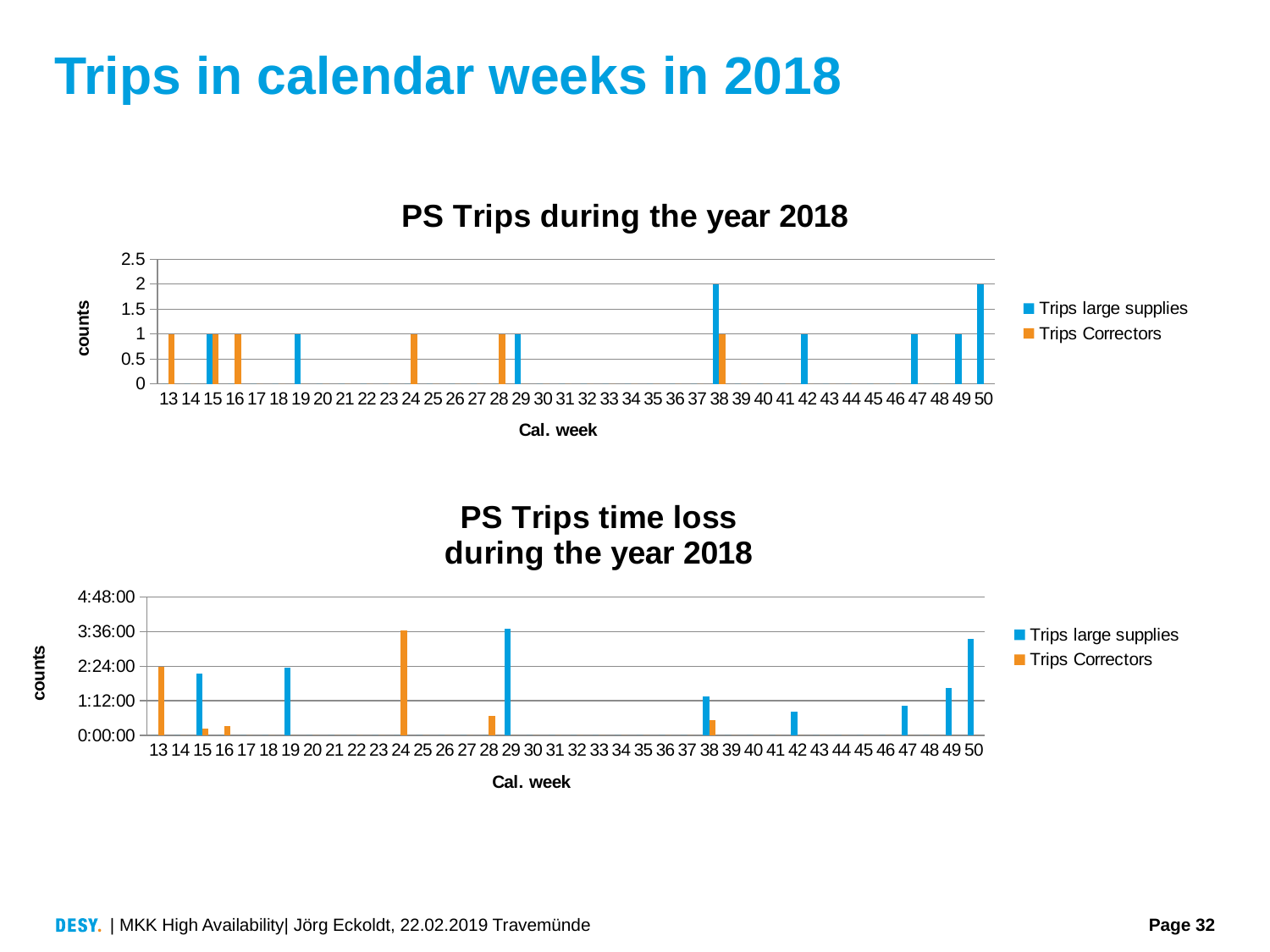
In the bottom chart 'PS Trips time loss during the year 2018', which calendar week has the highest Trips Correctors time loss? 24 In the top chart 'PS Trips during the year 2018', what is the difference between the Trips large supplies count in week 50 and in week 49? 1 In the top chart 'PS Trips during the year 2018', which calendar weeks have the highest count of Trips large supplies? 38 and 50 What kind of chart is the top chart titled 'PS Trips during the year 2018'? bar chart How many series does the legend of the top chart 'PS Trips during the year 2018' list? 2 In the bottom chart 'PS Trips time loss during the year 2018', is the Trips large supplies value for week 42 greater or less than 1:12:00? less What is the x-axis title of the bottom chart 'PS Trips time loss during the year 2018'? Cal. week In the top chart 'PS Trips during the year 2018', what is the count of Trips large supplies in calendar week 38? 2 In the top chart 'PS Trips during the year 2018', what is the count of Trips Correctors in calendar week 13? 1 How many calendar weeks are shown on the x axis of the top chart 'PS Trips during the year 2018'? 38 In the bottom chart 'PS Trips time loss during the year 2018', is the Trips Correctors value for week 24 greater or less than 2:24:00? greater In the top chart 'PS Trips during the year 2018', which is larger: the Trips large supplies count in week 38 or in week 42? week 38